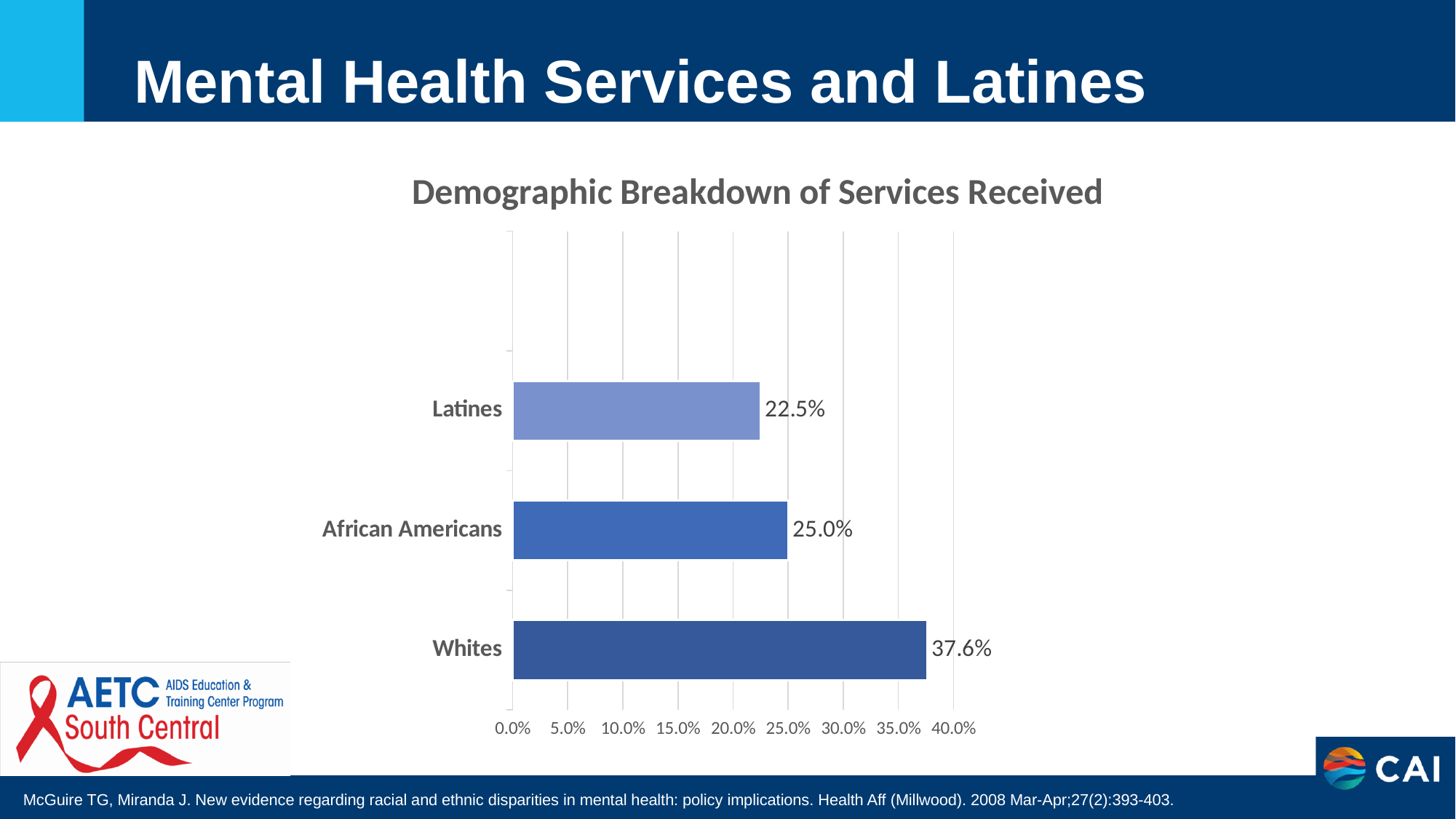
How many categories are shown in the chart? 3 Which is larger, the value for African Americans or the value for Latines? African Americans Is the value for Whites greater or less than 35.0%? greater What is the difference between the values for Whites and Latines? 15.1% What is the value for African Americans? 25.0% What is the title of the chart? Demographic Breakdown of Services Received What is the difference between the values for African Americans and Latines? 2.5% Which category has the highest value? Whites What kind of chart is shown on the slide? Bar chart What is the value for Whites? 37.6% Which category has the lowest value? Latines What is the value for Latines? 22.5%